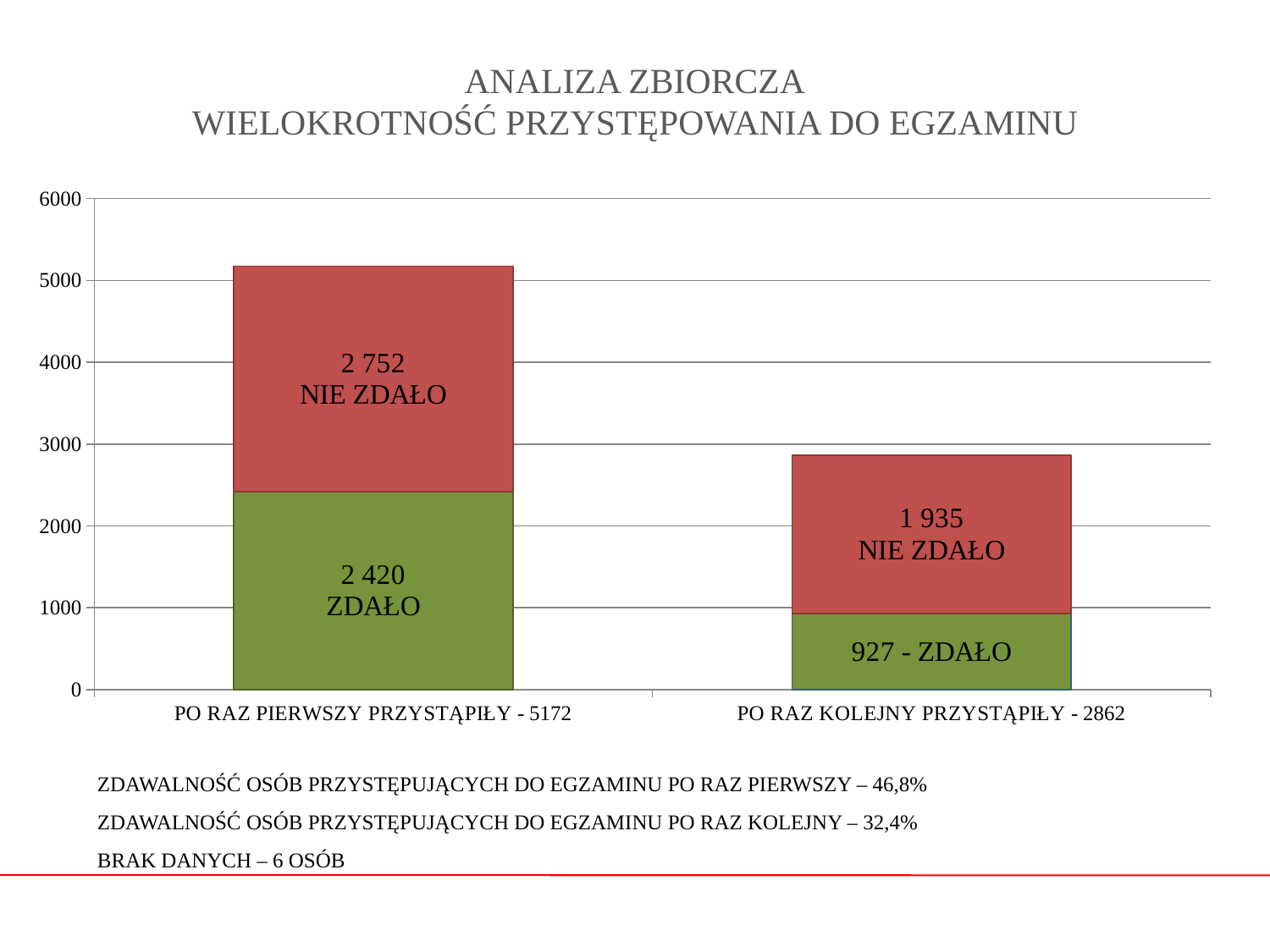
Is the total for PO RAZ KOLEJNY PRZYSTĄPIŁY greater or less than 3000? less How many people failed (NIE ZDAŁO) among those taking the exam again (PO RAZ KOLEJNY PRZYSTĄPIŁY)? 1 935 How many categories are shown on the x axis? 2 Which colour represents the NIE ZDAŁO (failed) segment in the bars? red What kind of chart is shown on the slide? stacked bar chart What is the total of the stacked bar for PO RAZ KOLEJNY PRZYSTĄPIŁY? 2862 How many people passed (ZDAŁO) among those taking the exam again (PO RAZ KOLEJNY PRZYSTĄPIŁY)? 927 How many people failed (NIE ZDAŁO) among those taking the exam for the first time (PO RAZ PIERWSZY PRZYSTĄPIŁY)? 2 752 What is the difference between the number who failed and the number who passed among first-time takers (PO RAZ PIERWSZY PRZYSTĄPIŁY)? 332 What is the total of the stacked bar for PO RAZ PIERWSZY PRZYSTĄPIŁY? 5172 Which category has the higher total bar, PO RAZ PIERWSZY PRZYSTĄPIŁY or PO RAZ KOLEJNY PRZYSTĄPIŁY? PO RAZ PIERWSZY PRZYSTĄPIŁY How many people passed (ZDAŁO) among those taking the exam for the first time (PO RAZ PIERWSZY PRZYSTĄPIŁY)? 2 420